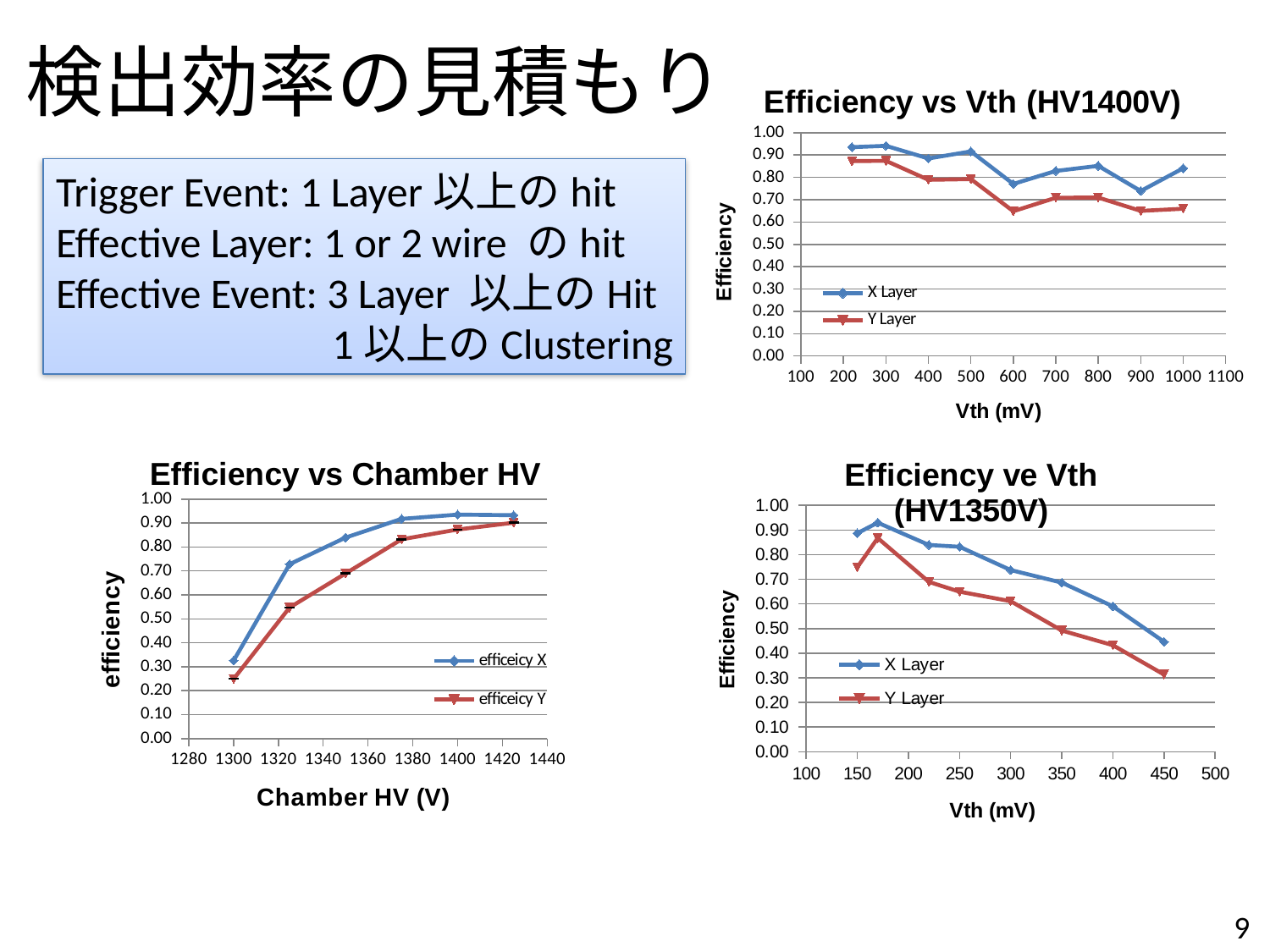
In the 'Efficiency vs Chamber HV' chart, how many data points does the efficeicy X series have? 6 In the 'Efficiency ve Vth (HV1350V)' chart, does the Y Layer efficiency rise or fall as Vth increases? fall What is the x-axis label of the 'Efficiency vs Chamber HV' chart? Chamber HV (V) In the 'Efficiency vs Chamber HV' chart, is the efficeicy X value at 1300 V greater or less than 0.40? less In the 'Efficiency vs Vth (HV1400V)' chart, how many data points does the X Layer series have? 9 What kind of chart is the 'Efficiency vs Chamber HV' chart? line chart In the 'Efficiency vs Vth (HV1400V)' chart, which series is higher at 600 mV, X Layer or Y Layer? X Layer In the 'Efficiency vs Chamber HV' chart, what are the two legend entries? efficeicy X and efficeicy Y In the 'Efficiency ve Vth (HV1350V)' chart, is the X Layer value at 150 mV greater or less than 0.80? greater In the 'Efficiency vs Vth (HV1400V)' chart, how many series does the legend list? 2 In the 'Efficiency vs Chamber HV' chart, does efficiency rise or fall as Chamber HV increases? rise In the 'Efficiency ve Vth (HV1350V)' chart, at which Vth is the Y Layer efficiency lowest? 450 mV